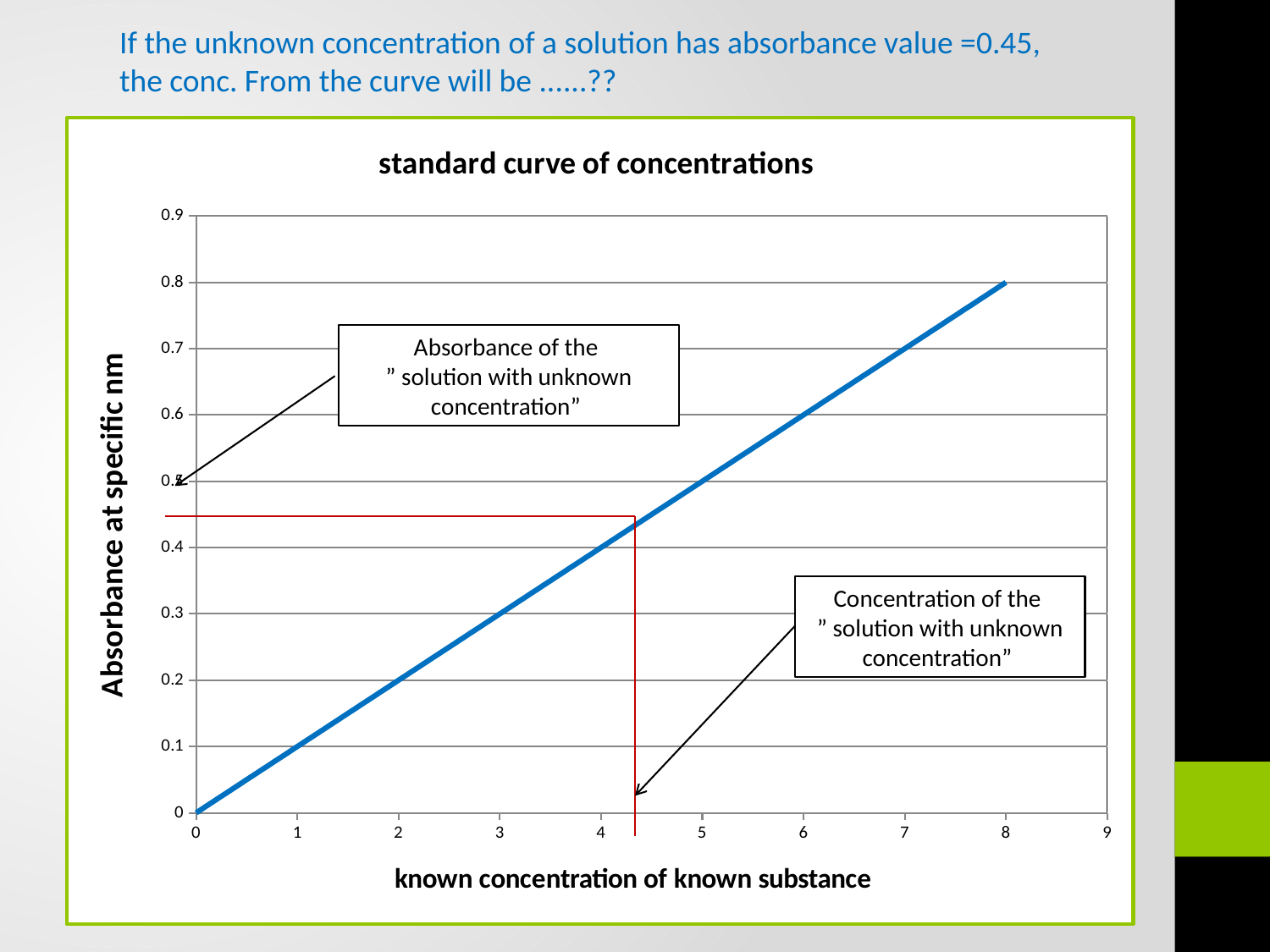
What is the highest value shown on the x axis of the chart? 9 What is the absorbance value at a known concentration of 0, where the line starts? 0 Which has the higher absorbance on the curve: a known concentration of 3 or a known concentration of 5? 5 What is the title of the chart? standard curve of concentrations What is the absorbance value at a known concentration of 8, where the line ends? 0.8 What is the highest value shown on the y axis of the chart? 0.9 What kind of chart is shown on the slide? line chart What is the label of the x axis of the chart? known concentration of known substance Is the absorbance at a known concentration of 6 greater or less than 0.5? greater Does the absorbance rise or fall as the known concentration increases along the x axis? rise Is the absorbance at a known concentration of 2 greater or less than 0.3? less Is the absorbance at a known concentration of 7 greater or less than 0.8? less